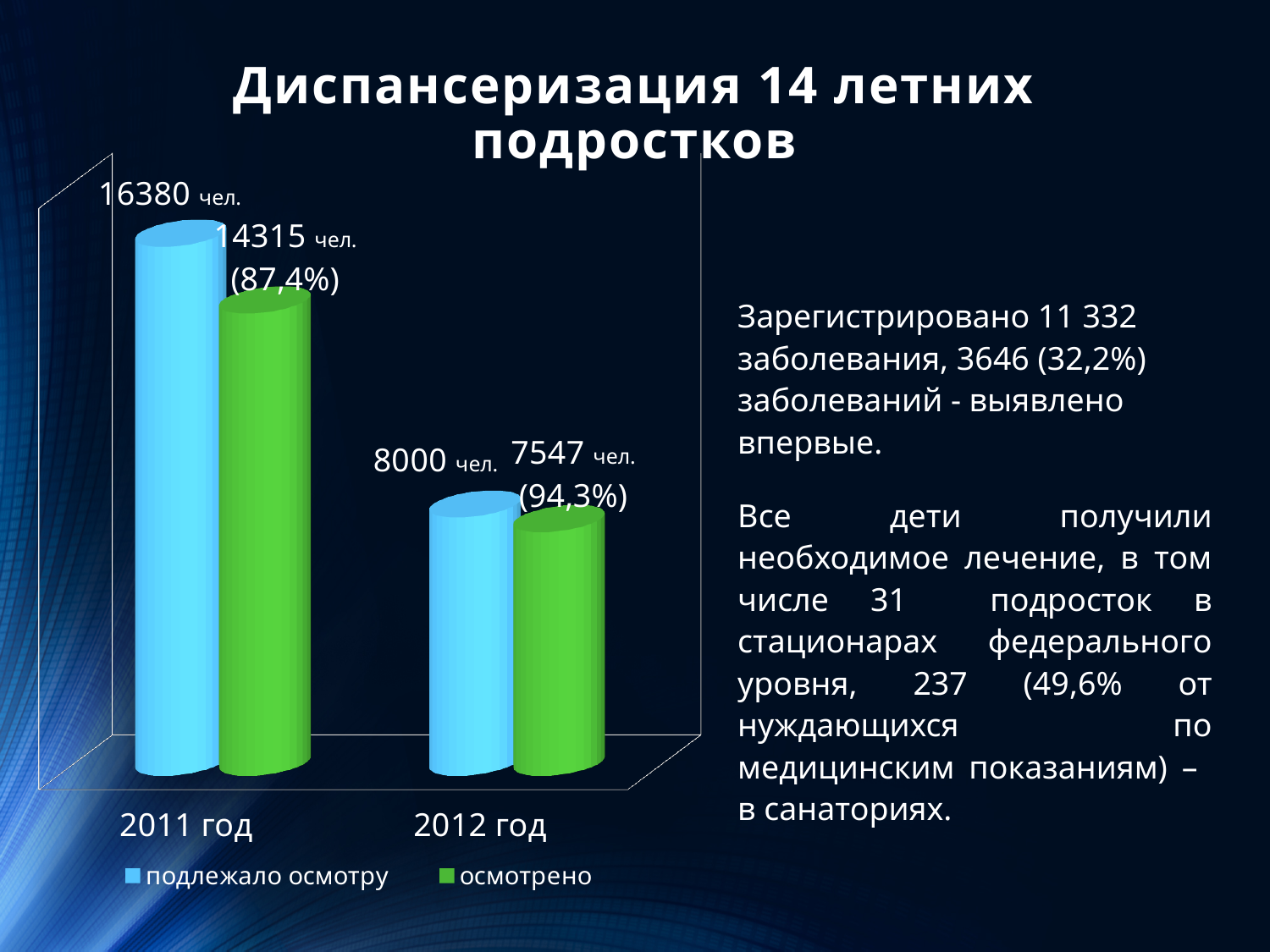
What percentage is printed next to the "осмотрено" bar for 2012 год? 94,3% What value is shown for "подлежало осмотру" in 2012 год? 8000 чел. What is the difference between "подлежало осмотру" and "осмотрено" in 2012 год? 453 What value is shown for "осмотрено" in 2011 год? 14315 чел. What value is shown for "подлежало осмотру" in 2011 год? 16380 чел. What kind of chart is shown on the slide? Bar chart Which year has the highest value for "подлежало осмотру"? 2011 год What percentage is printed next to the "осмотрено" bar for 2011 год? 87,4% Which is larger: "осмотрено" in 2011 год or "подлежало осмотру" in 2012 год? осмотрено in 2011 год What is the difference between "подлежало осмотру" and "осмотрено" in 2011 год? 2065 How many series does the legend list? 2 What value is shown for "осмотрено" in 2012 год? 7547 чел.